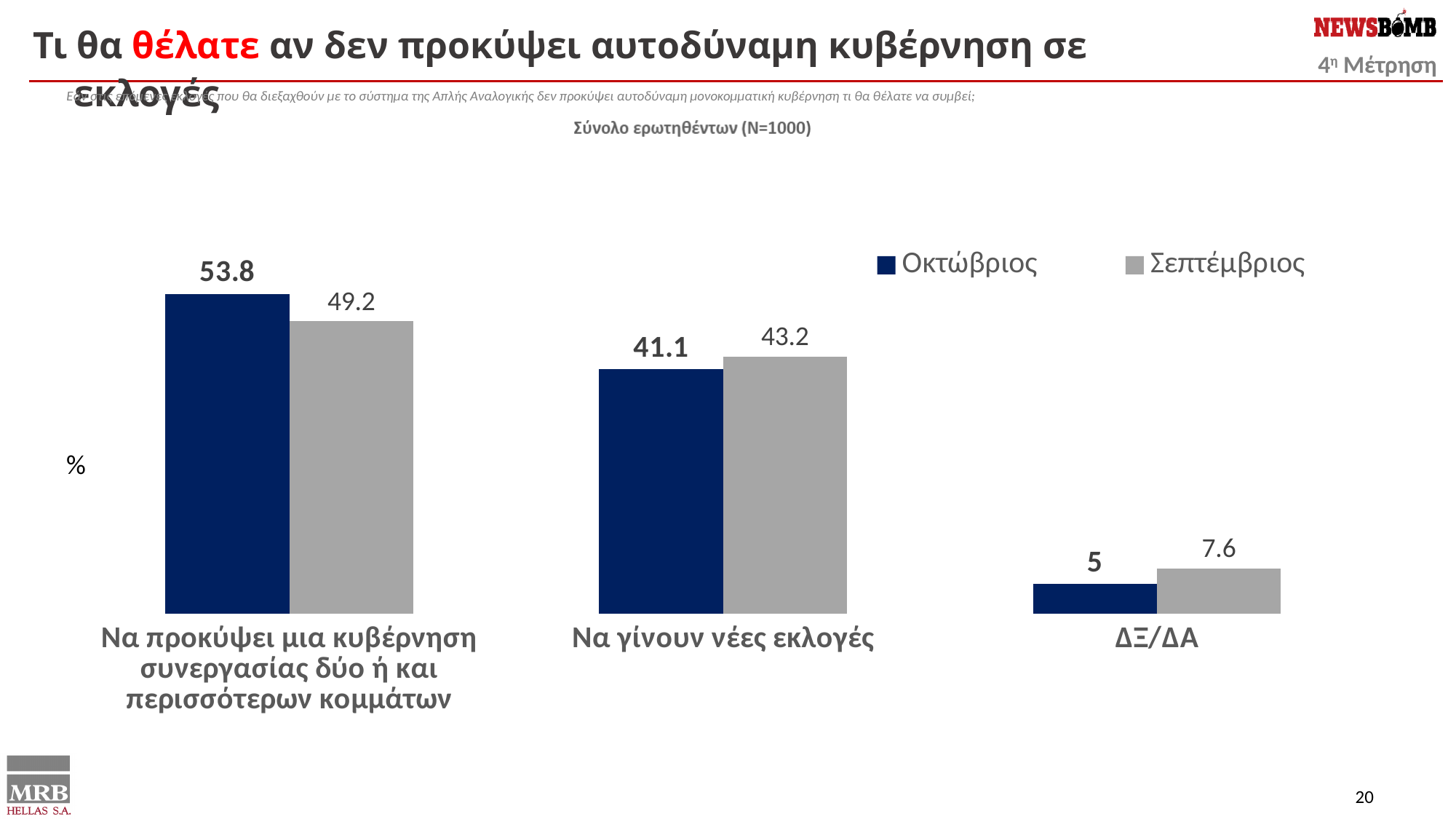
For 'Να γίνουν νέες εκλογές', which series has the larger value, Οκτώβριος or Σεπτέμβριος? Σεπτέμβριος What kind of chart is shown on the slide? Bar chart What is the value for Οκτώβριος in the category 'Να προκύψει μια κυβέρνηση συνεργασίας δύο ή και περισσότερων κομμάτων'? 53.8 What is the difference between the Οκτώβριος and Σεπτέμβριος values for 'Να προκύψει μια κυβέρνηση συνεργασίας δύο ή και περισσότερων κομμάτων'? 4.6 What is the difference between the Σεπτέμβριος and Οκτώβριος values for 'Να γίνουν νέες εκλογές'? 2.1 How many series does the legend list? 2 What is the value for Οκτώβριος in the category 'ΔΞ/ΔΑ'? 5 What is the value for Σεπτέμβριος in the category 'Να γίνουν νέες εκλογές'? 43.2 Which category has the lowest value for Σεπτέμβριος? ΔΞ/ΔΑ What is the value for Σεπτέμβριος in the category 'ΔΞ/ΔΑ'? 7.6 Which category has the highest value for Οκτώβριος? Να προκύψει μια κυβέρνηση συνεργασίας δύο ή και περισσότερων κομμάτων How many categories are shown on the x axis of the chart? 3